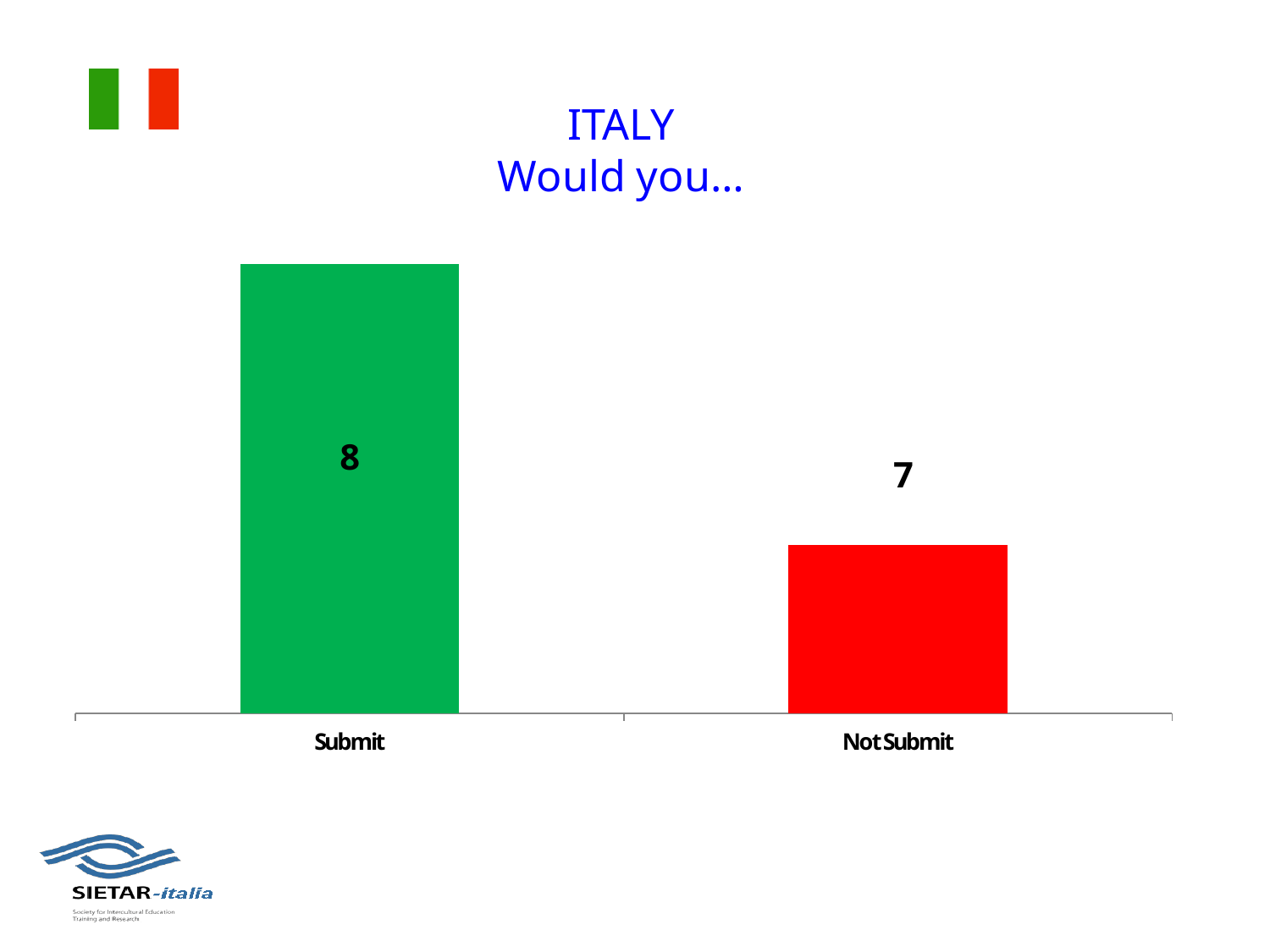
Which category has the lowest value? Not Submit How many categories are shown in the chart? 2 What kind of chart is shown on the slide? Bar chart What is the value for Not Submit? 7 What is the difference between the values for Submit and Not Submit? 1 Which category has the highest value? Submit What is the value for Submit? 8 What colour is the bar for Not Submit? Red Which is larger, the value for Submit or the value for Not Submit? Submit What colour is the bar for Submit? Green What is the total of the values for Submit and Not Submit? 15